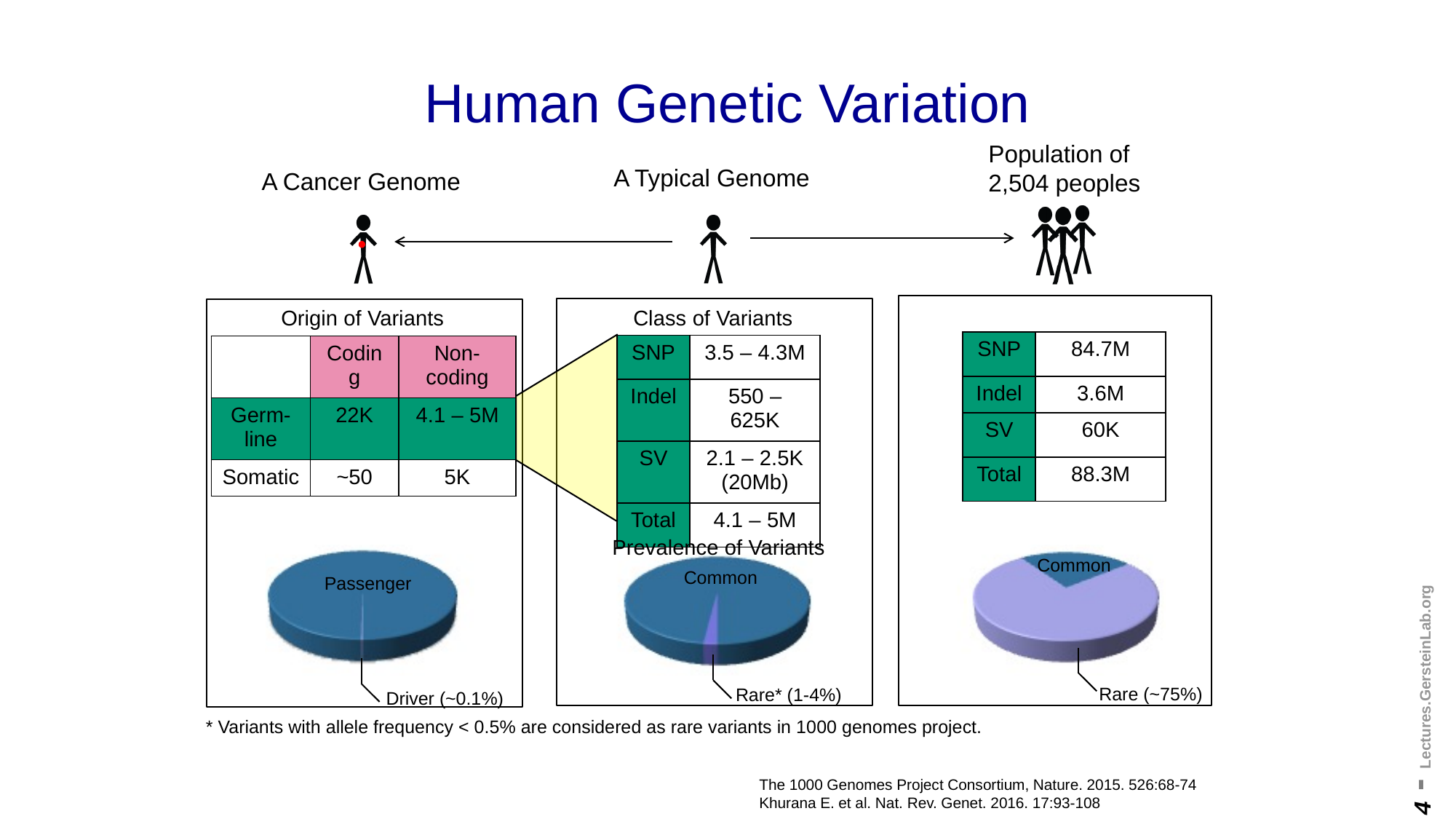
What label is attached to the small slice of the pie chart under "A Cancer Genome"? Driver (~0.1%) In the pie chart under "Population of 2,504 peoples", which slice is the smallest? Common How many pie charts are on the slide? 3 In the pie chart under "A Typical Genome", which slice is the smallest? Rare In the pie chart under "A Cancer Genome", which slice is larger, Passenger or Driver? Passenger What title is printed above the pie chart under "A Typical Genome"? Prevalence of Variants In the pie chart under "Population of 2,504 peoples", which slice is larger, Common or Rare? Rare In the pie chart under "A Cancer Genome", how many slices are there? 2 In the pie chart under "A Cancer Genome", which slice is the smallest? Driver In the pie chart under "A Typical Genome", how many slices are there? 2 What kind of chart is shown under "A Cancer Genome"? pie chart In the pie chart under "A Typical Genome", which slice is larger, Common or Rare? Common